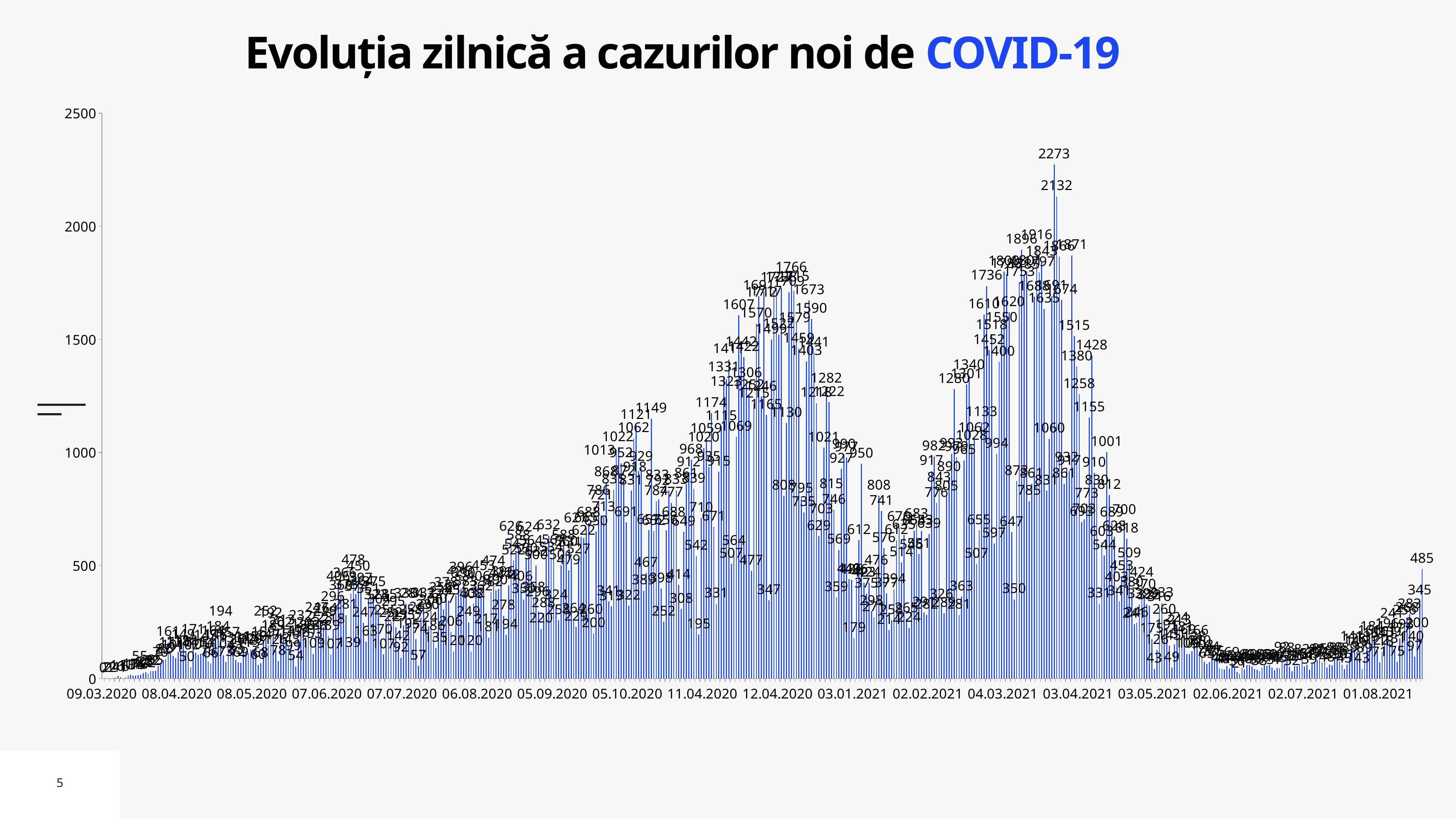
Do the values rise or fall between the 03.04.2021 tick and the 02.06.2021 tick? fall Is the value at the 02.06.2021 tick greater or less than 500? less What is the maximum value shown on the vertical axis? 2500 What is the difference between the last bar (485) and the bar labelled 345 just before it? 140 What is the value of the last (rightmost) bar on the chart? 485 What is the difference between the two highest labelled values, 2273 and 2132? 141 What is the title of the chart? Evoluția zilnică a cazurilor noi de COVID-19 What is the second-highest value labelled on the chart, next to the 2273 peak? 2132 What kind of chart is shown on the slide? bar chart What is the highest daily value labelled on the chart? 2273 Is the highest bar on the chart greater or less than 2000? greater Which is larger, the bar labelled 2273 or the bar labelled 2132? 2273